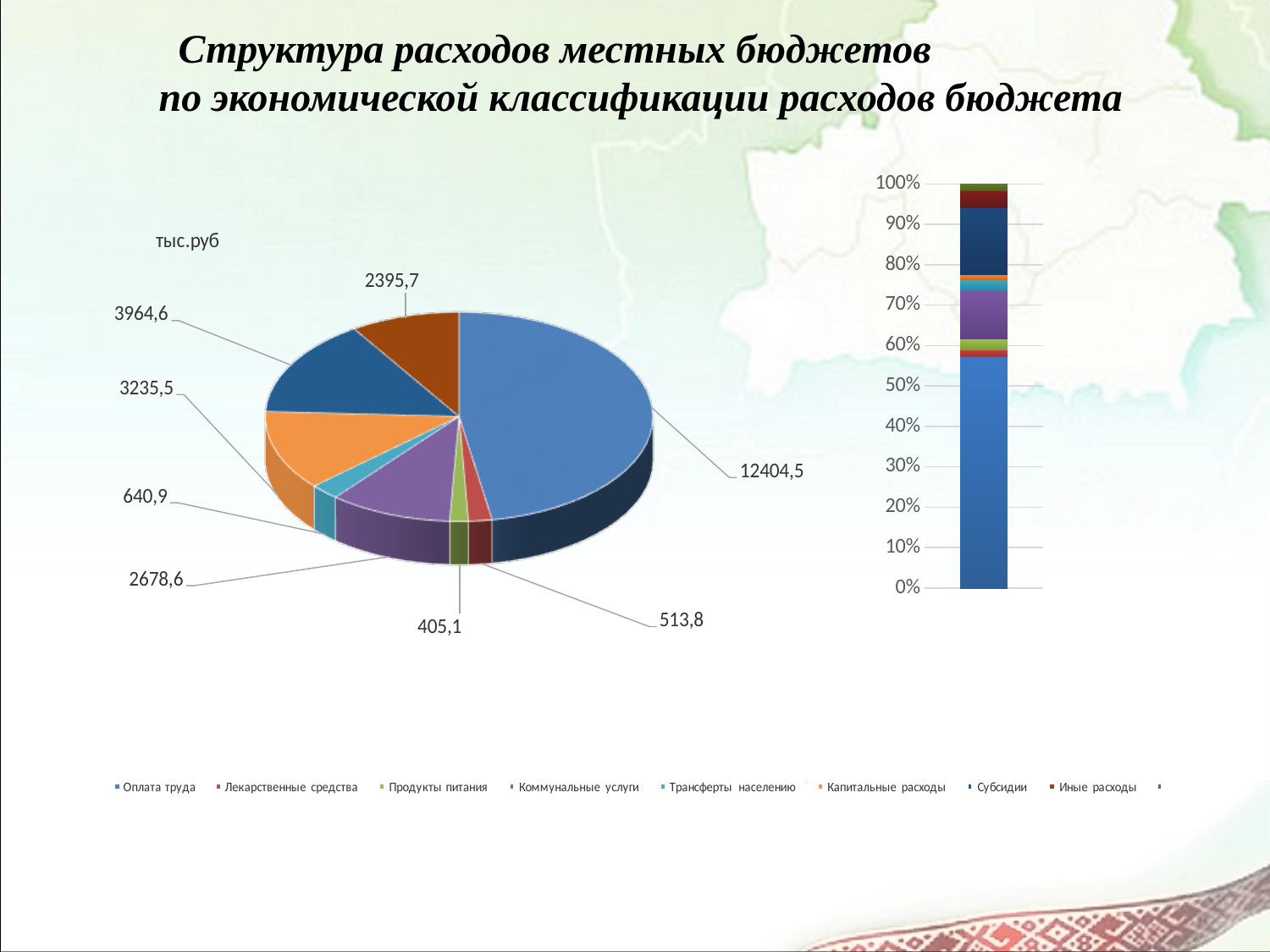
In the stacked bar chart on the right, is the top of the Оплата труда segment greater or less than 50%? greater In the pie chart, which category has the largest value? Оплата труда What unit is shown above the pie chart? тыс.руб In the pie chart, what is the difference between the values for Субсидии and Капитальные расходы? 729,1 What kind of chart is the chart on the left of the slide? Pie chart How many slices does the pie chart have? 8 In the pie chart, what is the value for Капитальные расходы? 3235,5 In the pie chart, which is larger: Коммунальные услуги or Иные расходы? Коммунальные услуги In the pie chart, what is the value for Трансферты населению? 640,9 In the pie chart, what is the value for Субсидии? 3964,6 In the pie chart, which category has the smallest value? Продукты питания In the pie chart, what is the value for Оплата труда? 12404,5